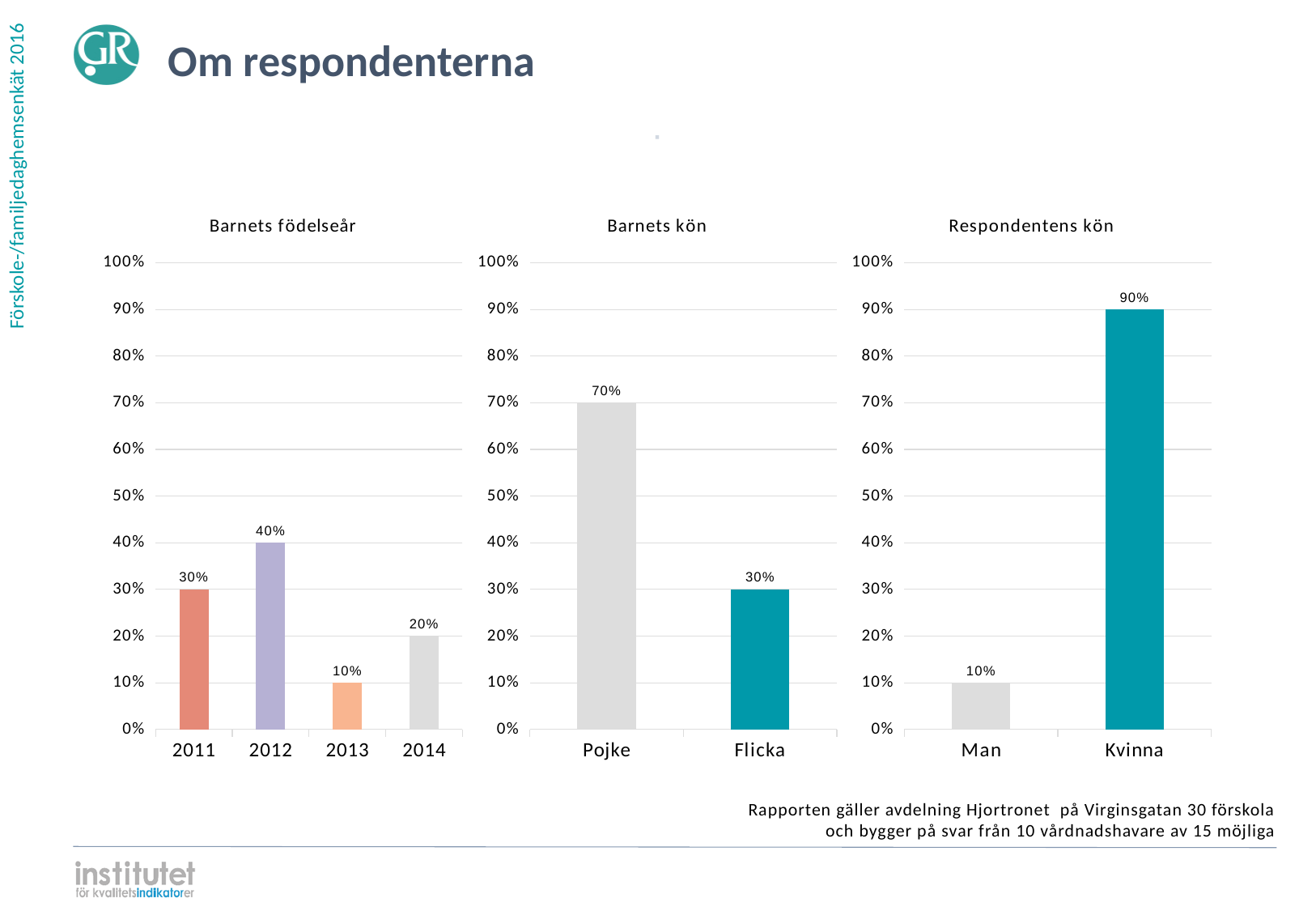
In the 'Barnets födelseår' chart, what is the difference between the values for 2011 and 2014? 10% In the 'Barnets födelseår' chart, which birth year has the lowest value? 2013 In the 'Barnets kön' chart, what is the value for Pojke? 70% What kind of chart is the 'Respondentens kön' chart? Bar chart In the 'Barnets födelseår' chart, how many birth-year categories are shown? 4 In the 'Barnets kön' chart, what is the difference between Pojke and Flicka? 40% In the 'Respondentens kön' chart, what is the value for Man? 10% In the 'Barnets födelseår' chart, which birth year has the highest value? 2012 In the 'Respondentens kön' chart, what is the value for Kvinna? 90% How many charts are shown on the slide? 3 In the 'Barnets födelseår' chart, what is the value for 2012? 40% In the 'Barnets kön' chart, which is larger, Pojke or Flicka? Pojke